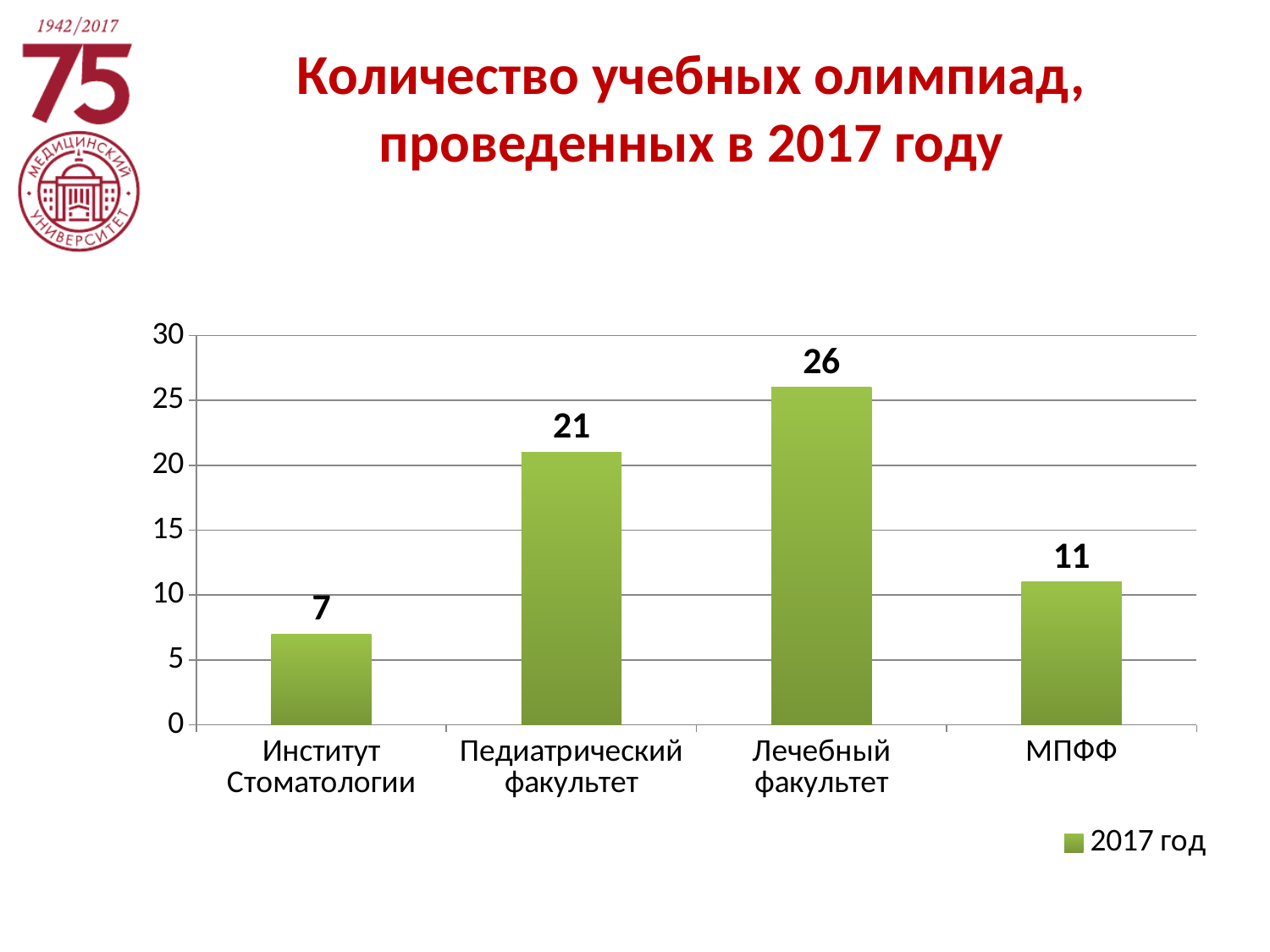
Which is larger, the value for Педиатрический факультет or the value for МПФФ? Педиатрический факультет What is the difference between the values for Лечебный факультет and Педиатрический факультет? 5 What is the value for Институт Стоматологии? 7 What series name does the legend show? 2017 год What kind of chart is shown on the slide? bar chart Which category has the highest value? Лечебный факультет What is the difference between the values for МПФФ and Институт Стоматологии? 4 What is the value for МПФФ? 11 How many categories are shown on the x axis? 4 What is the value for Педиатрический факультет? 21 Which category has the lowest value? Институт Стоматологии Is the value for Лечебный факультет greater or less than 25? greater